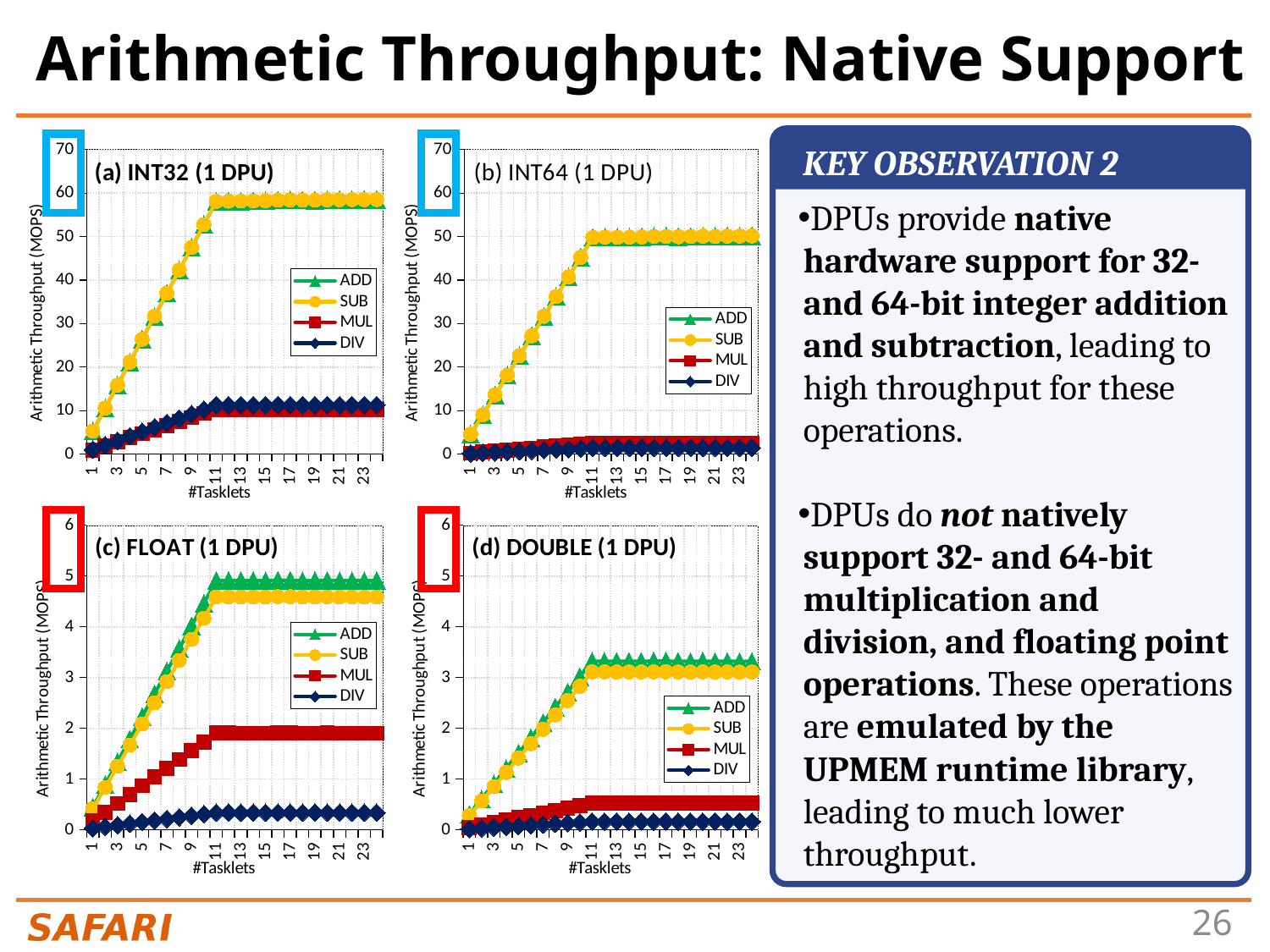
What kind of chart is the (a) INT32 (1 DPU) chart? line chart In the (c) FLOAT (1 DPU) chart, which series has the lowest throughput? DIV In the (c) FLOAT (1 DPU) chart, which is larger at 23 tasklets, MUL or DIV? MUL In the (d) DOUBLE (1 DPU) chart, which series has the lowest throughput? DIV What is the label of the x axis on the (b) INT64 (1 DPU) chart? #Tasklets In the (b) INT64 (1 DPU) chart, is the MUL throughput at 23 tasklets greater or less than 10 MOPS? less In the (d) DOUBLE (1 DPU) chart, is the ADD throughput at 23 tasklets greater or less than 2 MOPS? greater What is the title of the bottom-right chart on the slide? (d) DOUBLE (1 DPU) In the (c) FLOAT (1 DPU) chart, is the MUL throughput at 23 tasklets greater or less than 1 MOPS? greater In the (a) INT32 (1 DPU) chart, does the ADD throughput rise or fall as the number of tasklets increases from 1 to 11? rise How many series does the legend of the (c) FLOAT (1 DPU) chart list? 4